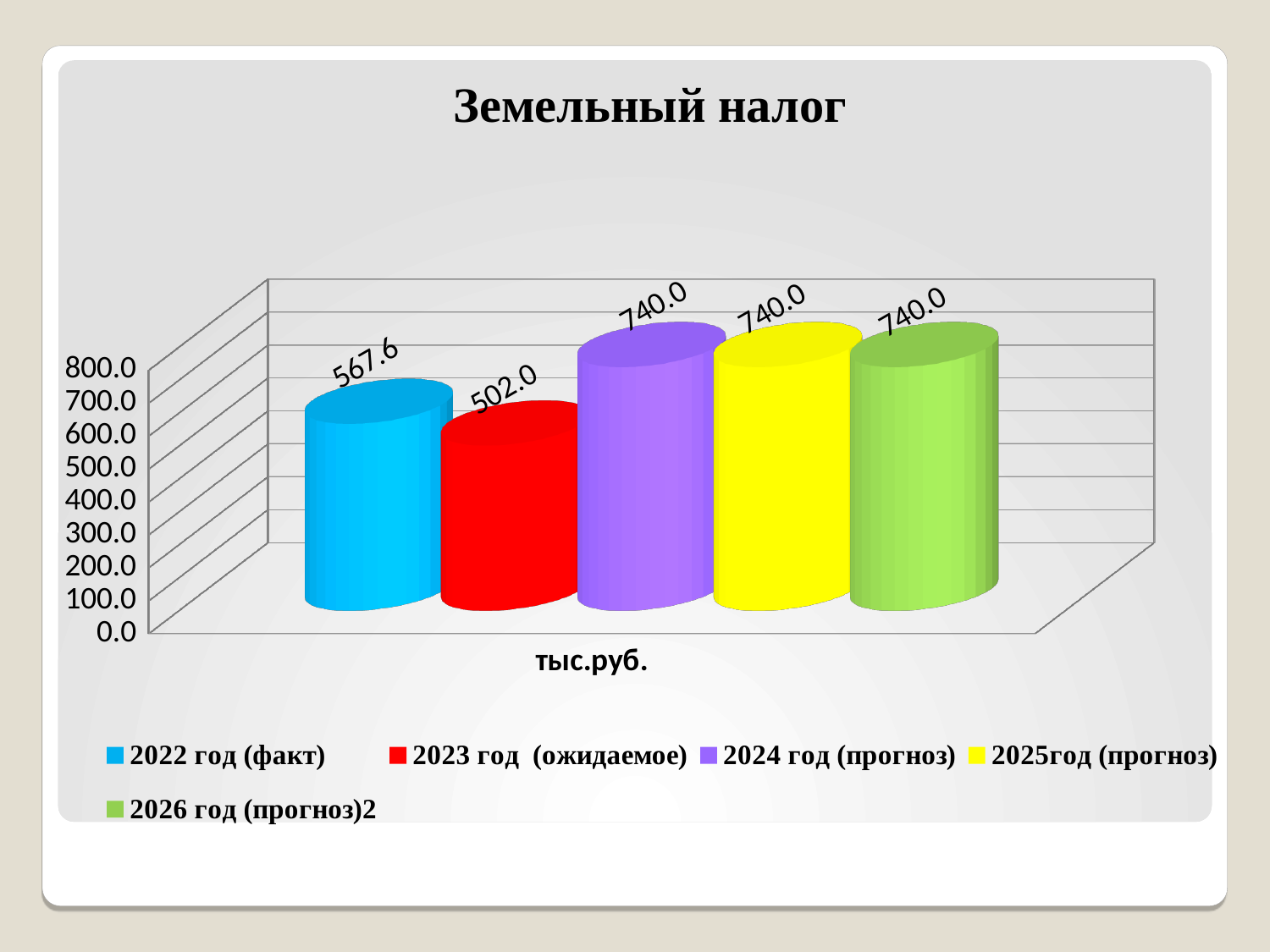
What is the value for 2023 год (ожидаемое) in the Земельный налог chart? 502.0 What is the difference between the values for 2022 год (факт) and 2023 год (ожидаемое)? 65.6 Which is larger: the value for 2022 год (факт) or the value for 2023 год (ожидаемое)? 2022 год (факт) What is the value for 2022 год (факт) in the Земельный налог chart? 567.6 How many series does the legend list in the Земельный налог chart? 5 What is the title of the chart on the slide? Земельный налог What is the value for 2024 год (прогноз) in the Земельный налог chart? 740.0 What is the difference between the values for 2024 год (прогноз) and 2022 год (факт)? 172.4 What kind of chart is shown on the slide? bar chart Which series has the lowest value in the Земельный налог chart? 2023 год (ожидаемое) Is the value for 2025год (прогноз) greater or less than 700.0? greater What is the value for 2026 год (прогноз)2 in the Земельный налог chart? 740.0